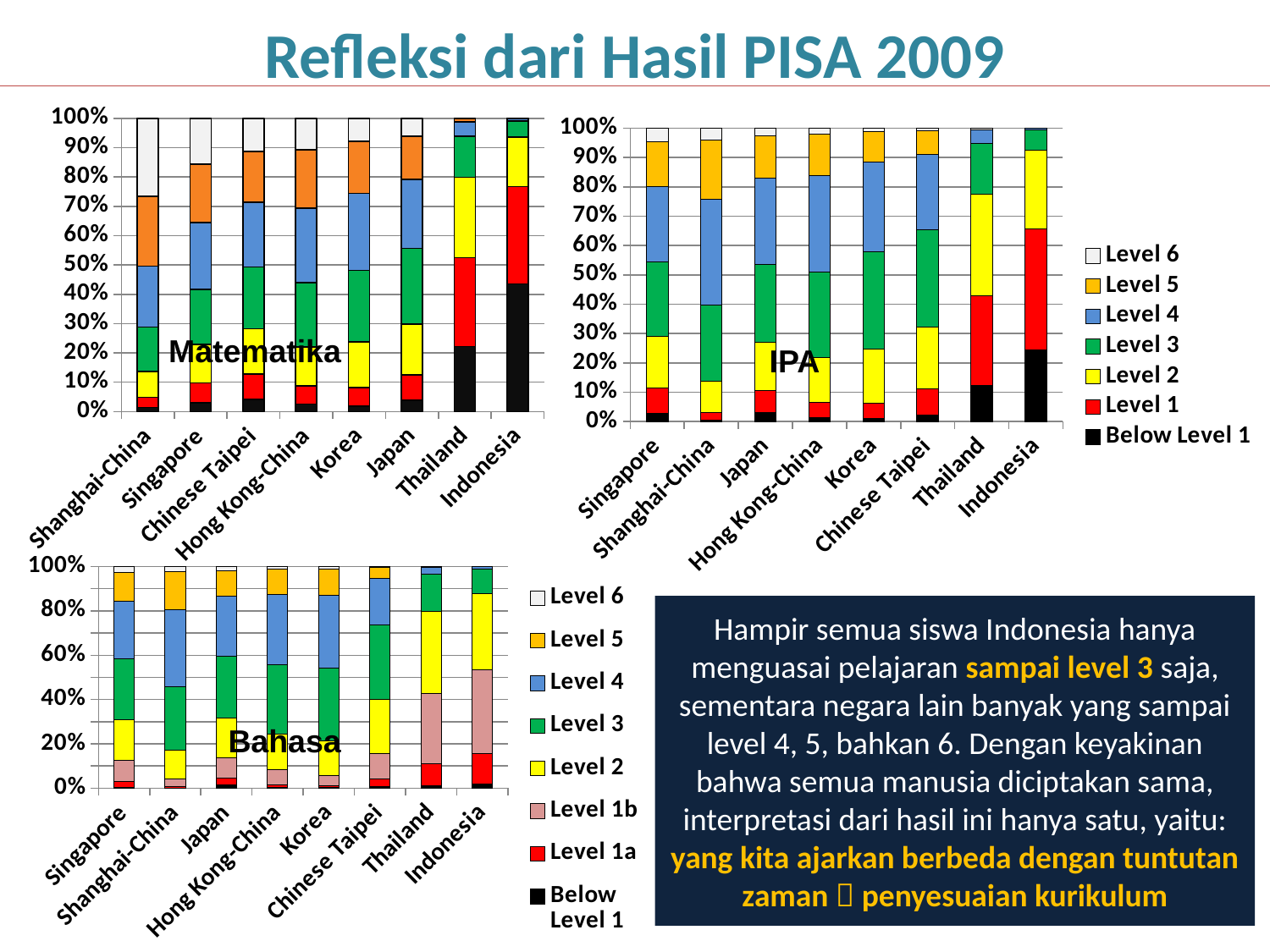
What kind of chart is the Matematika chart? Stacked bar chart In the IPA chart, which country has the largest Level 1 share? Indonesia In the Bahasa chart, is the Level 1b share for Indonesia greater or less than 20%? greater How many series does the legend of the Bahasa chart list? 8 In the IPA chart, is the Below Level 1 share for Thailand greater or less than 20%? less In the Matematika chart, is the Below Level 1 share for Indonesia greater or less than 30%? greater In the Matematika chart, which country has the largest Level 6 share? Shanghai-China Which colour represents Level 3 in the charts' legends? Green How many series does the legend next to the IPA chart list? 7 In the Matematika chart, which has the larger Below Level 1 share, Thailand or Indonesia? Indonesia How many countries are shown on the x axis of the IPA chart? 8 In the Matematika chart, which country has the largest Below Level 1 share? Indonesia